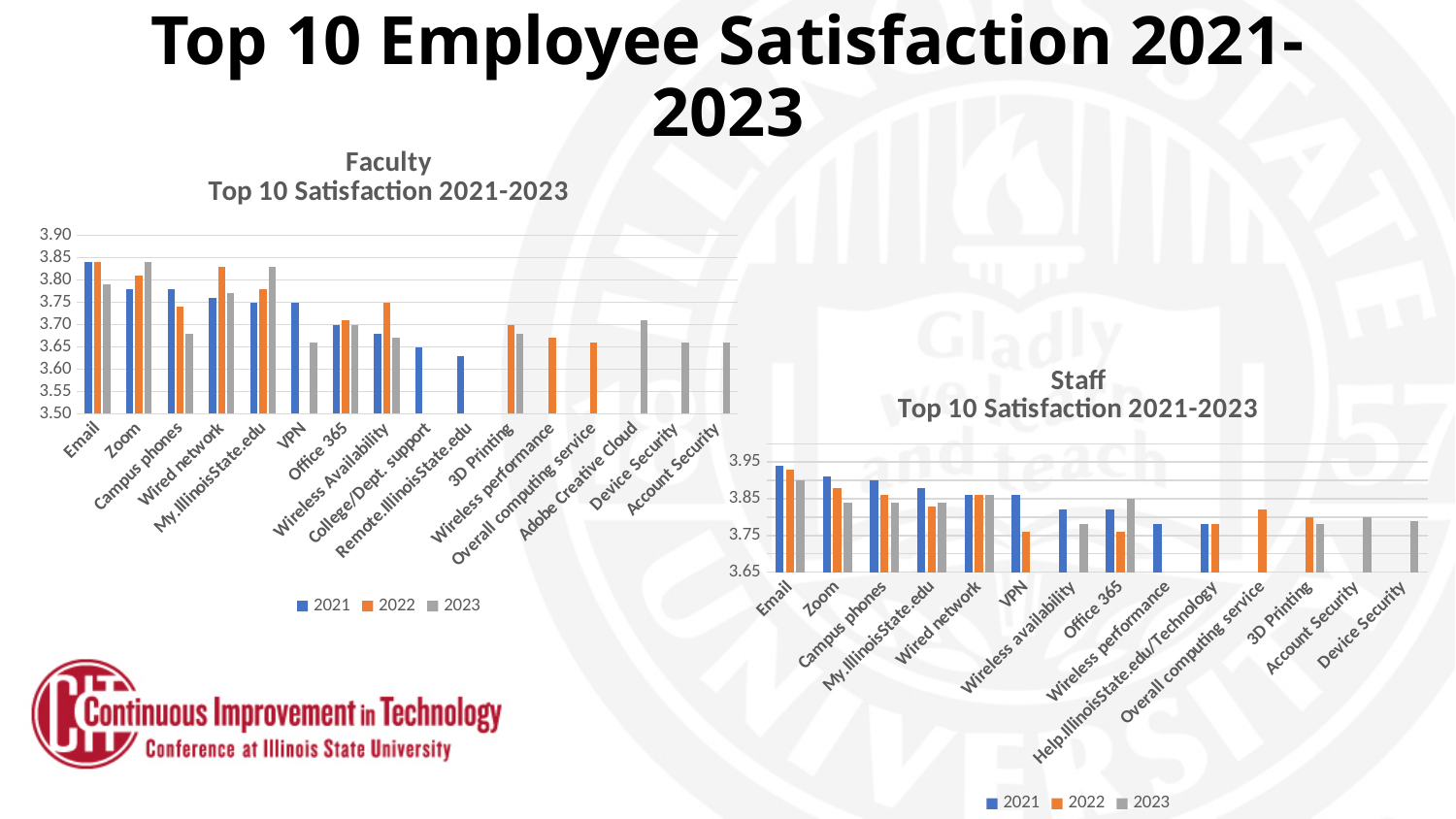
In the Staff Top 10 Satisfaction 2021-2023 chart, is the 2021 value for Email greater or less than 3.85? greater How many series does the legend of the Staff Top 10 Satisfaction 2021-2023 chart list? 3 In the Faculty Top 10 Satisfaction 2021-2023 chart, is the 2023 value for VPN greater or less than 3.70? less In the Faculty Top 10 Satisfaction 2021-2023 chart, which category has the highest 2021 value? Email Which years are listed in the legend of the Faculty Top 10 Satisfaction 2021-2023 chart? 2021, 2022, 2023 How many categories are shown on the x axis of the Staff Top 10 Satisfaction 2021-2023 chart? 14 In the Faculty Top 10 Satisfaction 2021-2023 chart, is the 2021 value for Email greater or less than 3.80? greater How many categories are shown on the x axis of the Faculty Top 10 Satisfaction 2021-2023 chart? 16 In the Faculty Top 10 Satisfaction 2021-2023 chart, which is larger: the 2021 value for Email or the 2023 value for Account Security? 2021 value for Email In the Faculty Top 10 Satisfaction 2021-2023 chart, do the 2021 values rise or fall moving from Email to Remote.IllinoisState.edu along the x axis? fall What kind of chart is the Faculty Top 10 Satisfaction 2021-2023 chart? bar chart